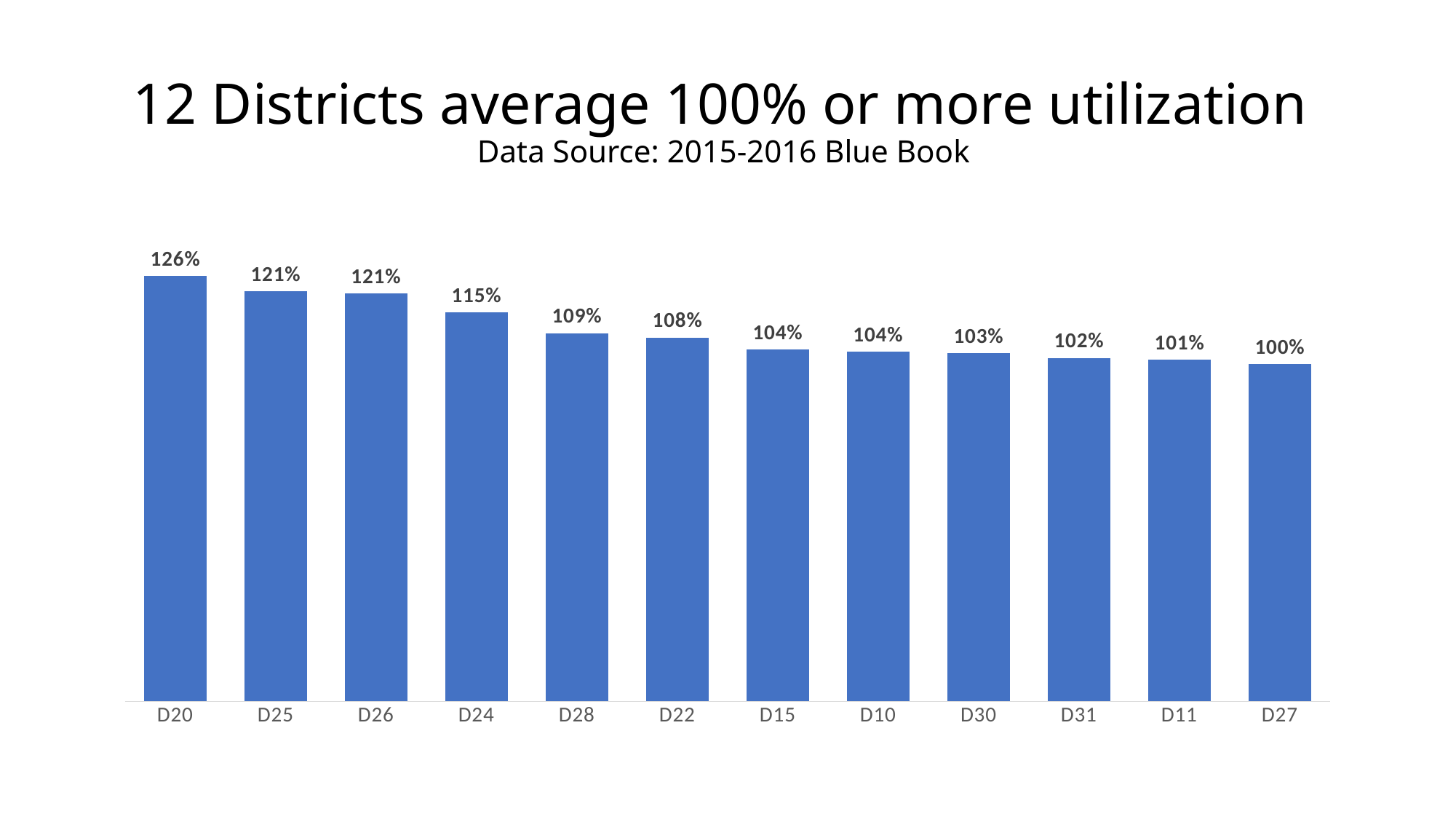
What is the difference between the utilization of D20 and D27? 26% Which has a higher utilization, D28 or D15? D28 Which district has the lowest utilization? D27 Which district has the highest utilization? D20 What kind of chart is shown on the slide? Bar chart What is the utilization value for D30? 103% What is the utilization value for D20? 126% What is the utilization value for D24? 115% What is the utilization value for D27? 100% What is the difference between the utilization of D24 and D28? 6% How many districts are shown in the chart? 12 Do the values rise or fall from left to right along the x axis? Fall